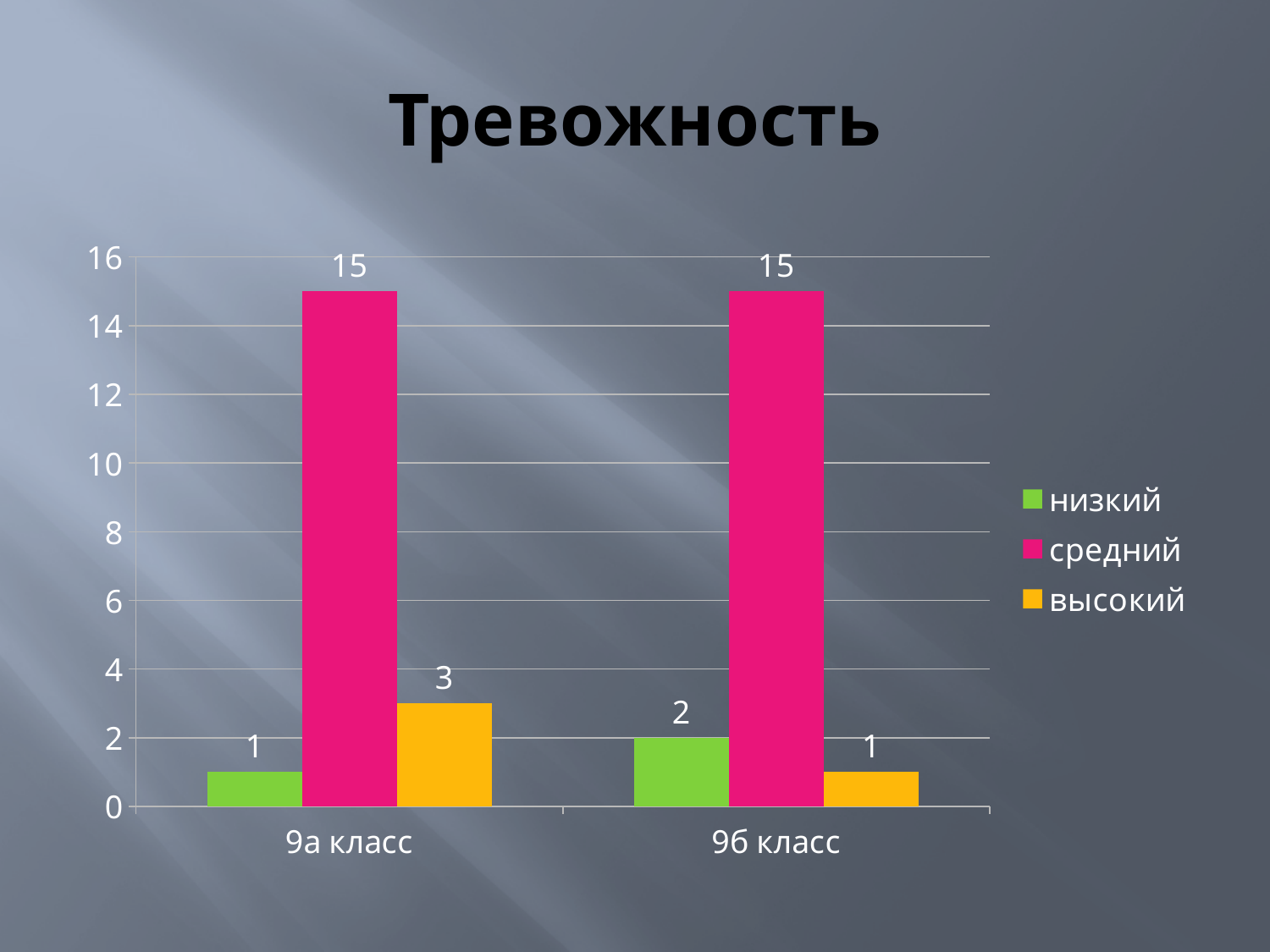
What is the title of the chart? Тревожность What is the value for низкий in 9а класс? 1 Which series has the highest value in 9а класс? средний What kind of chart is shown on the slide? bar chart What is the value for высокий in 9а класс? 3 What is the value for средний in 9б класс? 15 Which is larger: высокий in 9а класс or высокий in 9б класс? высокий in 9а класс What is the difference between средний and высокий in 9а класс? 12 How many categories are shown on the x axis? 2 What is the value for низкий in 9б класс? 2 How many series does the legend list? 3 Which series has the lowest value in 9б класс? высокий